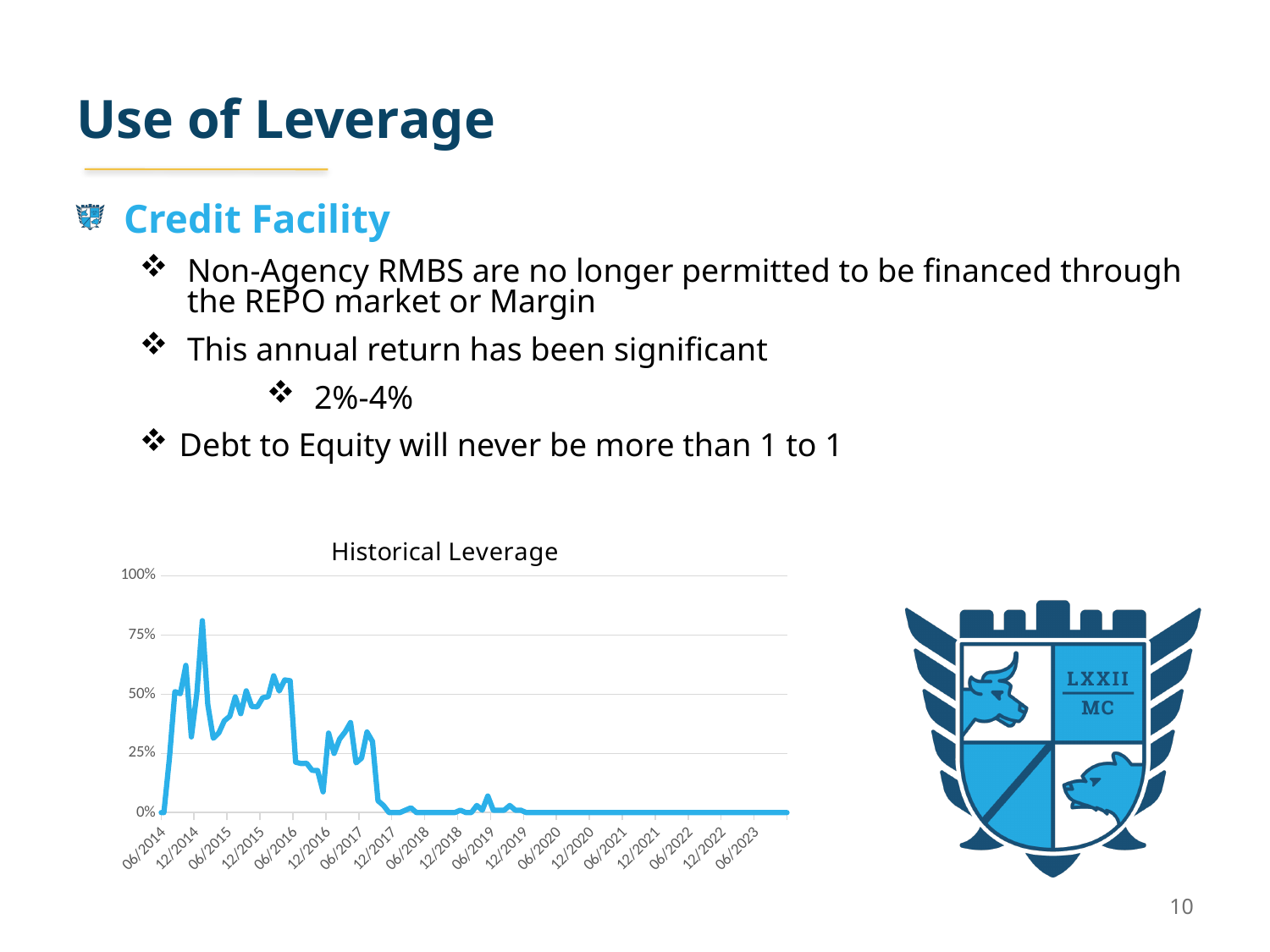
In the Historical Leverage chart, is the value at 12/2016 greater or less than 50%? less In the Historical Leverage chart, which is larger, the value at 12/2015 or the value at 06/2021? 12/2015 What is the highest value shown on the y-axis of the Historical Leverage chart? 100% In the Historical Leverage chart, is the value at 12/2015 greater or less than 25%? greater Does the leverage in the Historical Leverage chart generally rise or fall from 12/2015 to 06/2023? fall In the Historical Leverage chart, is the value at 06/2021 greater or less than 25%? less In the Historical Leverage chart, which is larger, the value at 12/2014 or the value at 12/2016? 12/2014 What kind of chart is the Historical Leverage chart? line chart What is the first date label on the x-axis of the Historical Leverage chart? 06/2014 What is the title of the chart on the slide? Historical Leverage How many date labels are shown on the x-axis of the Historical Leverage chart? 19